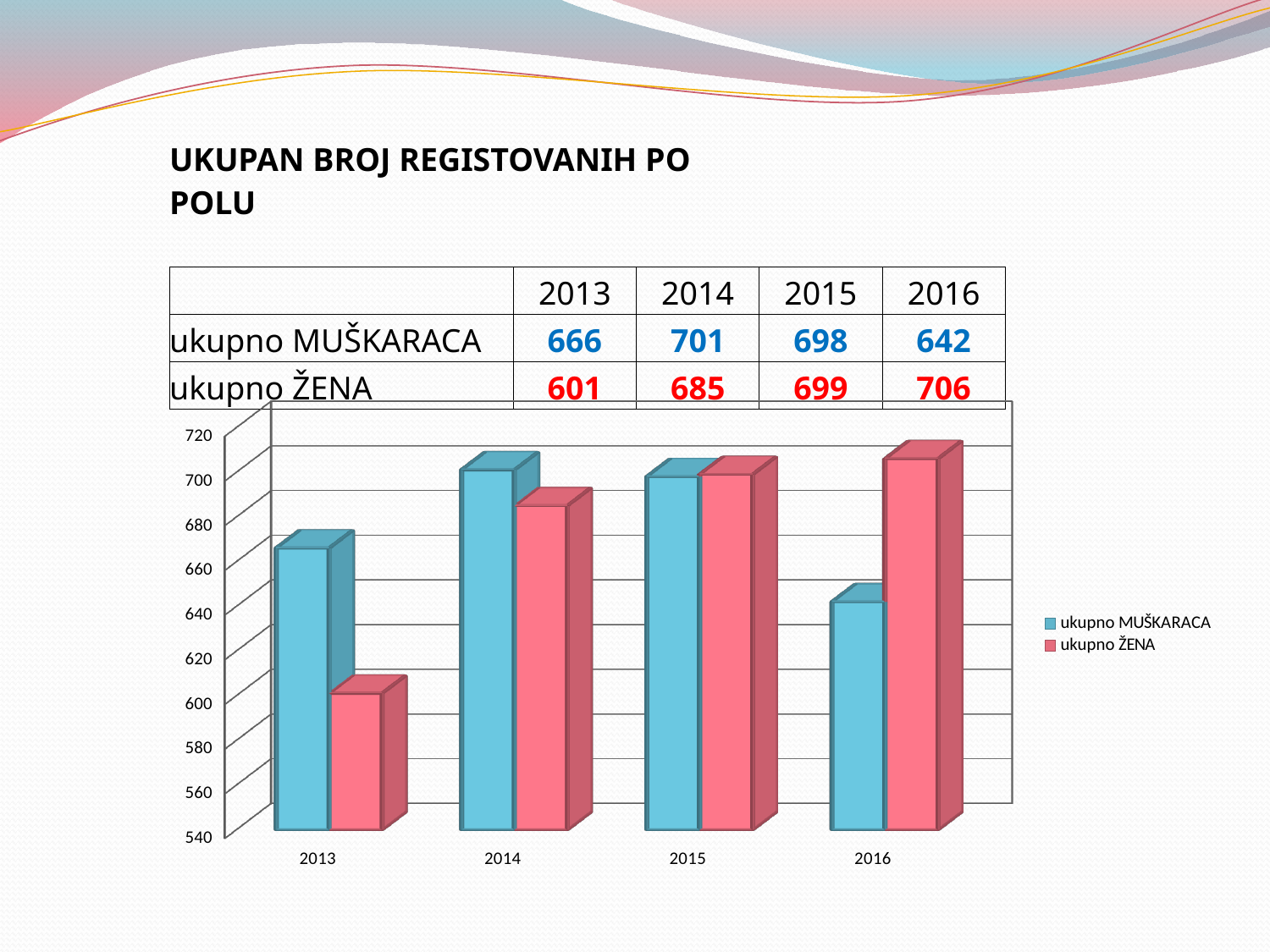
Is the value for ukupno MUŠKARACA in 2016 greater or less than 660? less Which is larger in 2016, ukupno MUŠKARACA or ukupno ŽENA? ukupno ŽENA What is the value for ukupno ŽENA in 2016? 706 What is the value for ukupno ŽENA in 2013? 601 What is the value for ukupno MUŠKARACA in 2014? 701 Do the values for ukupno ŽENA rise or fall from 2013 to 2016? rise How many years are shown on the x axis of the chart? 4 How many series does the chart legend list? 2 In which year is the value for ukupno MUŠKARACA the lowest? 2016 In which year is the value for ukupno ŽENA the highest? 2016 What kind of chart is shown on the slide? bar chart What is the difference between ukupno MUŠKARACA and ukupno ŽENA in 2013? 65